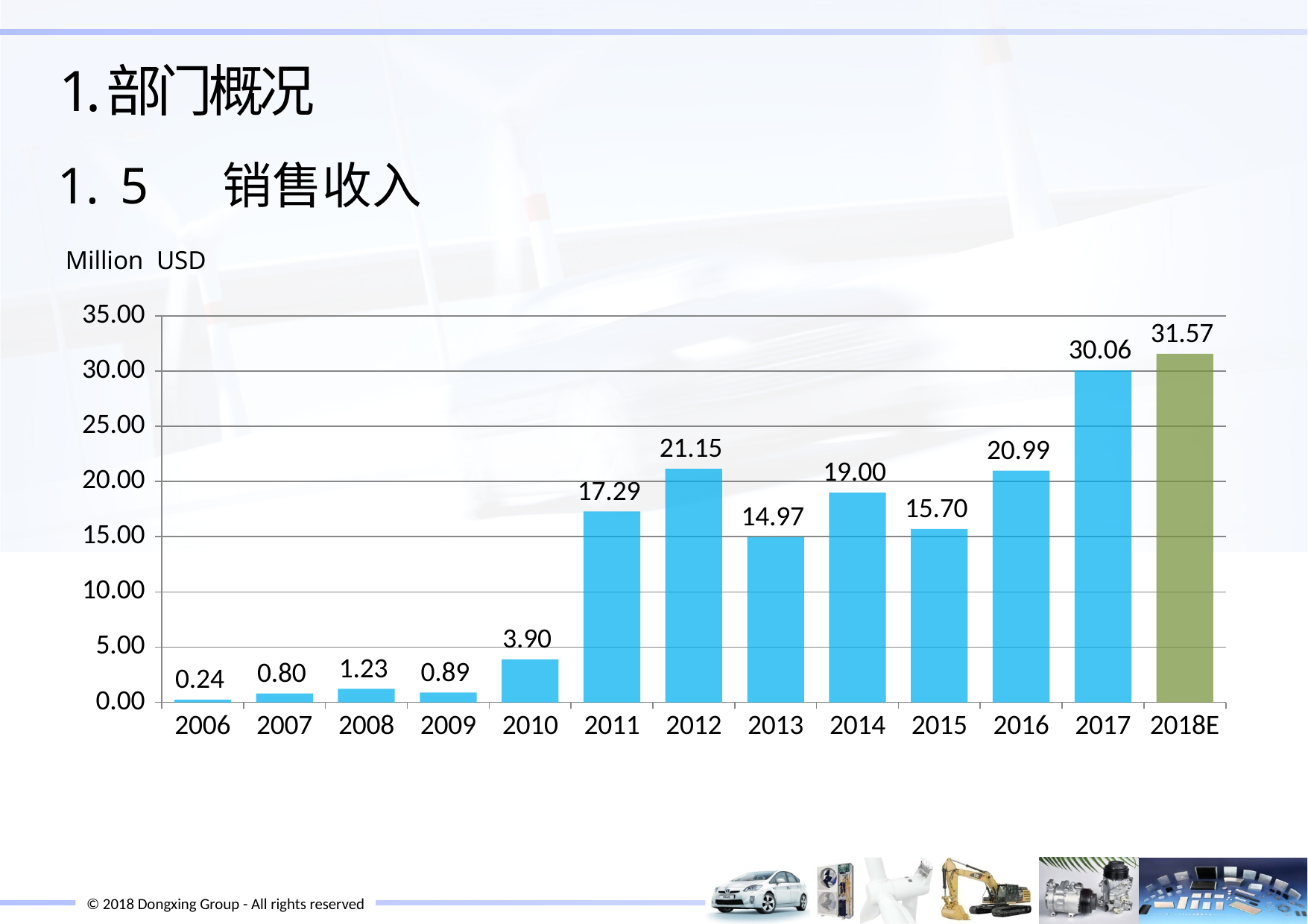
Which year has the highest value on the chart? 2018E What kind of chart is shown on the slide? bar chart Which is larger, the value for 2013 or the value for 2015? 2015 What is the value shown for 2006? 0.24 Do the values generally rise or fall from 2006 to 2018E? rise What unit is stated above the chart? Million USD Which year has the lowest value on the chart? 2006 How many years (categories) are shown on the x axis? 13 What is the sales revenue value shown for 2012? 21.15 Is the value for 2011 greater or less than 15.00? greater What is the value shown for 2018E? 31.57 What is the difference between the values for 2017 and 2016? 9.07